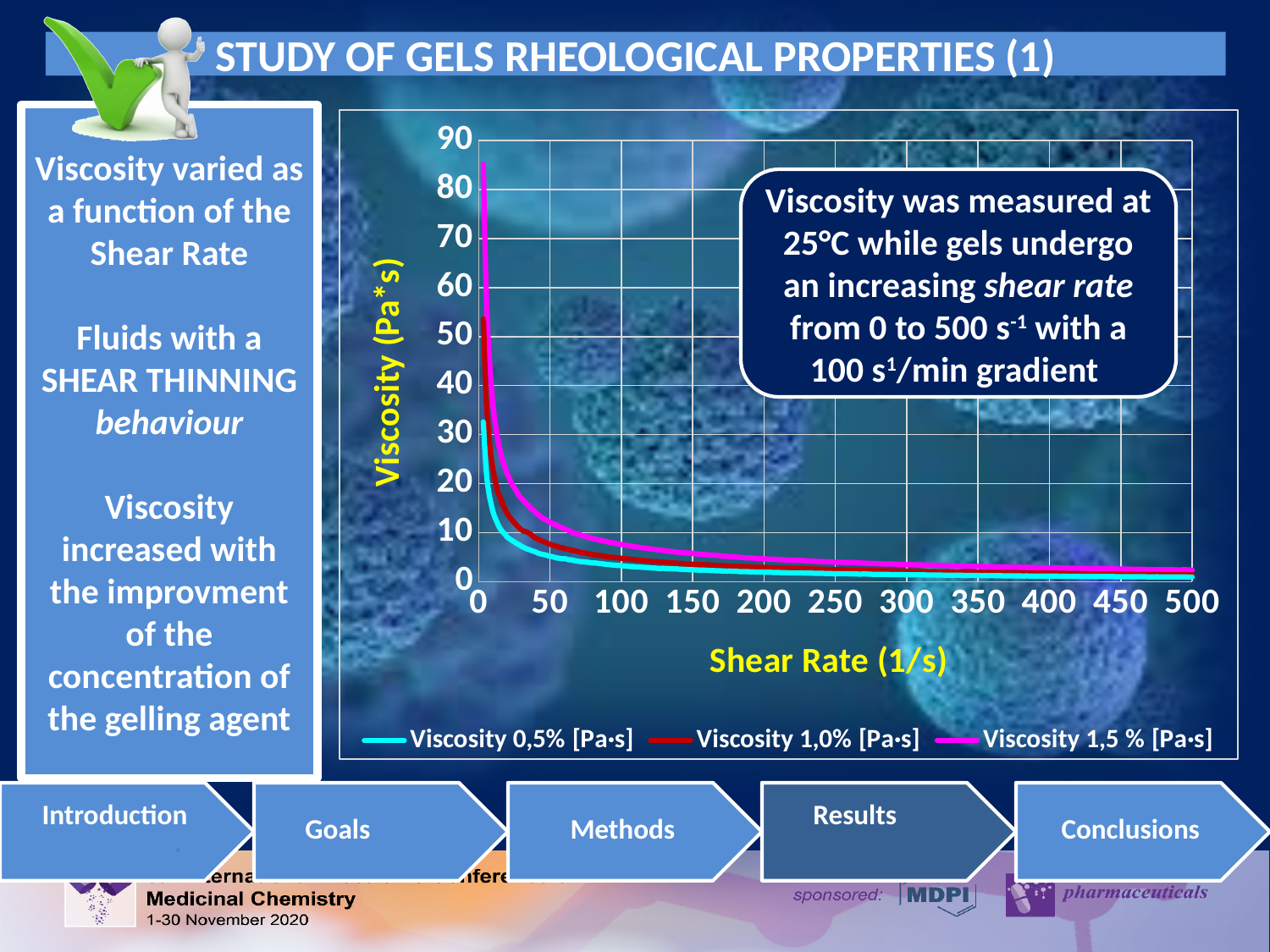
Near shear rate 0, which series has the larger viscosity: Viscosity 1,0% or Viscosity 0,5%? Viscosity 1,0% [Pa·s] Which series has the lowest viscosity across the shear rate range? Viscosity 0,5% [Pa·s] Is the starting viscosity of the Viscosity 0,5% series (near shear rate 0) greater or less than 20? greater Which series reaches the highest viscosity on the chart? Viscosity 1,5 % [Pa·s] Is the starting viscosity of the Viscosity 1,0% series (near shear rate 0) greater or less than 40? greater What kind of chart is shown on the slide? line chart What colour is the line for the Viscosity 1,5 % series? magenta Do the viscosity values rise or fall as the shear rate increases along the x axis? fall How many series does the legend list? 3 At a shear rate of 500, is the viscosity of the Viscosity 1,5 % series greater or less than 10? less What is the label of the x axis of the chart? Shear Rate (1/s)